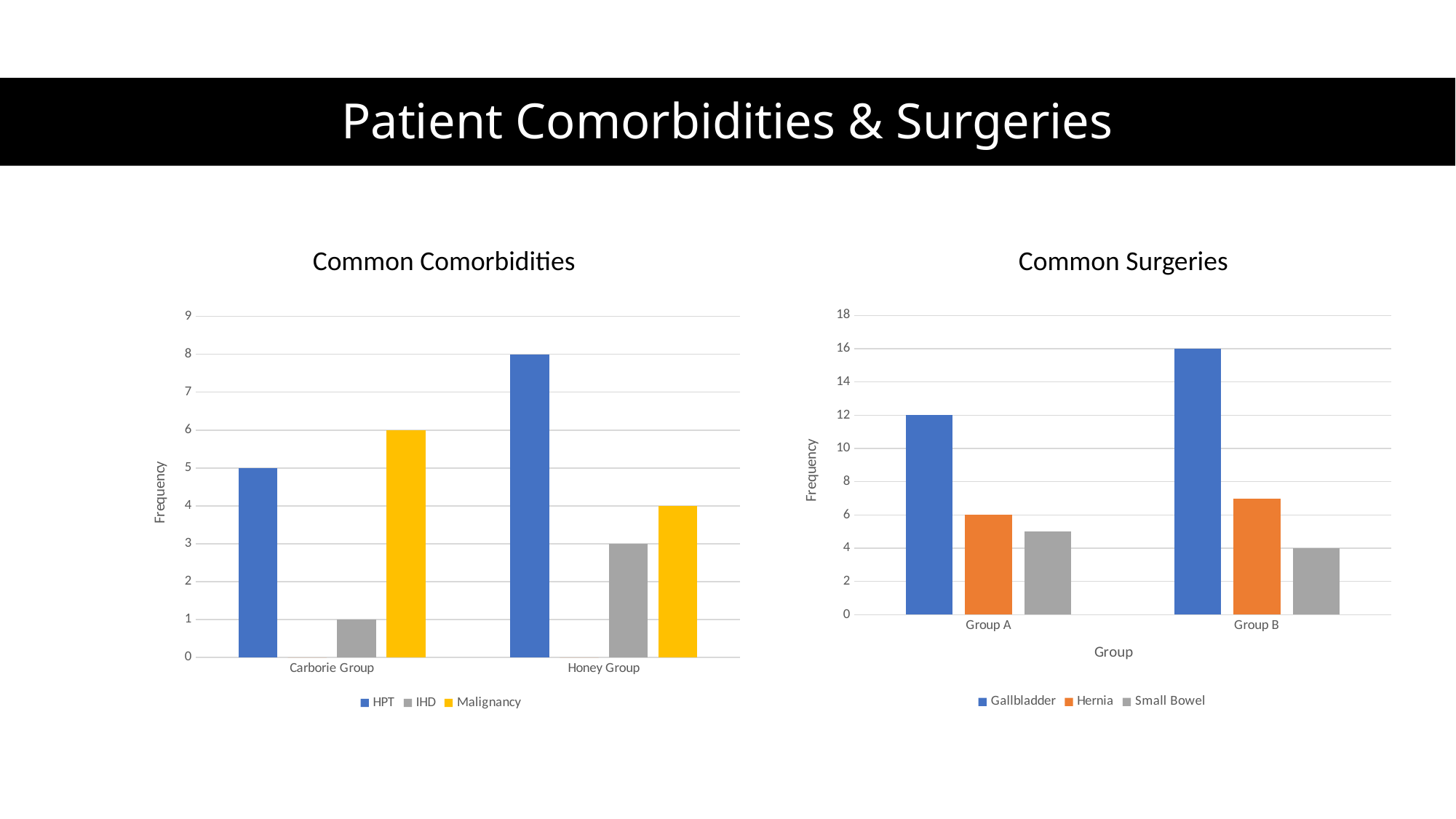
In the Common Comorbidities chart, which series has the highest value for the Honey Group? HPT In the Common Comorbidities chart, what is the HPT value for the Honey Group? 8 In the Common Surgeries chart, what is the Gallbladder value for Group B? 16 In the Common Surgeries chart, which is larger: the Hernia value for Group A or the Small Bowel value for Group A? Hernia In the Common Surgeries chart, what is the Gallbladder value for Group A? 12 In the Common Comorbidities chart, what is the IHD value for the Carborie Group? 1 In the Common Comorbidities chart, how many series does the legend list? 3 What kind of chart is the Common Surgeries chart? Bar chart In the Common Comorbidities chart, what is the Malignancy value for the Carborie Group? 6 In the Common Surgeries chart, is the Hernia value for Group B greater or less than 8? less In the Common Comorbidities chart, what is the difference between the HPT values for the Honey Group and the Carborie Group? 3 In the Common Surgeries chart, which series has the lowest value for Group B? Small Bowel